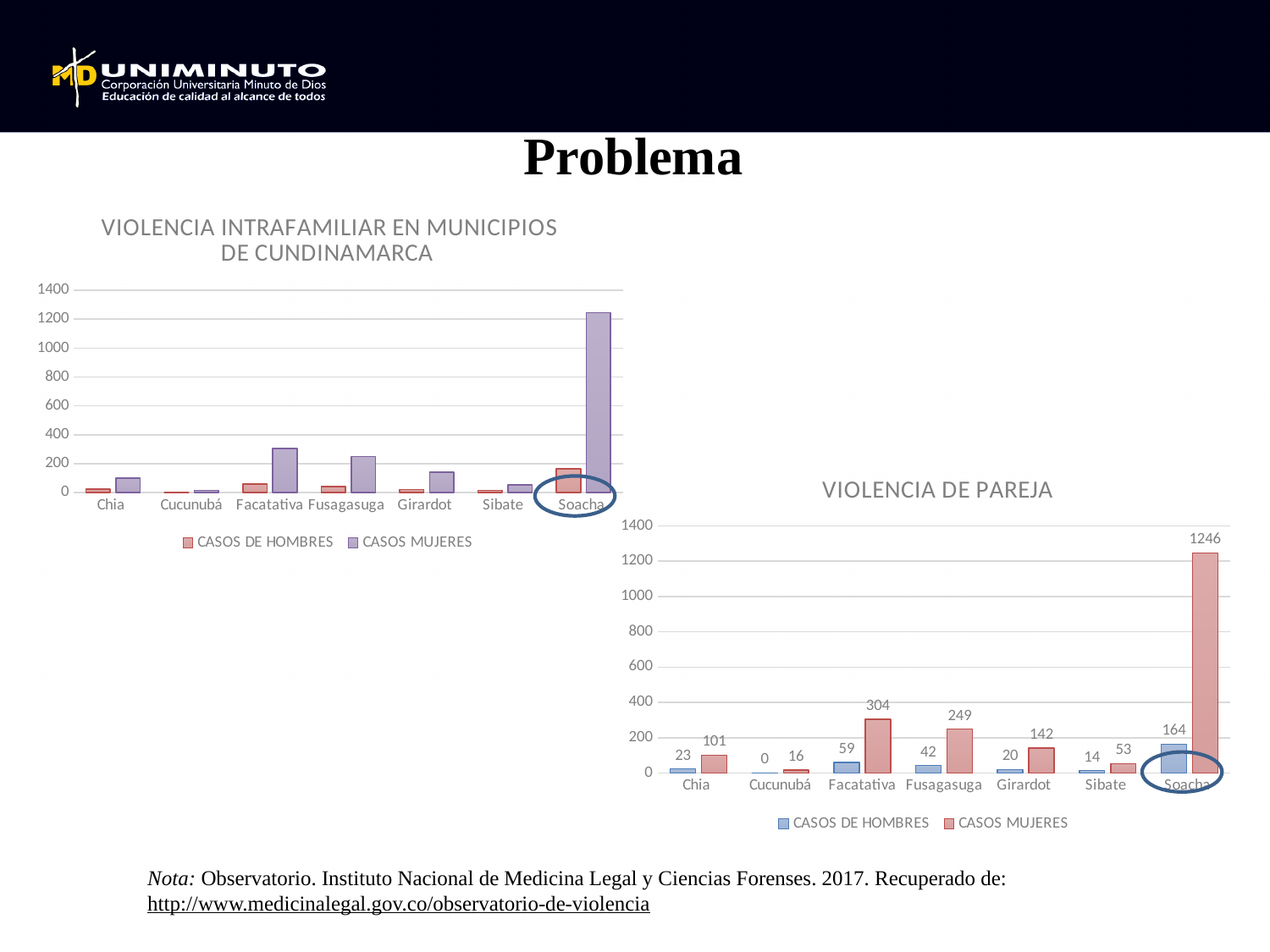
In the VIOLENCIA DE PAREJA chart, what is the value of CASOS DE HOMBRES for Facatativa? 59 In the VIOLENCIA DE PAREJA chart, how many series does the legend list? 2 In the VIOLENCIA DE PAREJA chart, what is the difference between CASOS MUJERES and CASOS DE HOMBRES for Fusagasuga? 207 In the VIOLENCIA DE PAREJA chart, what is the value of CASOS MUJERES for Girardot? 142 In the VIOLENCIA INTRAFAMILIAR EN MUNICIPIOS DE CUNDINAMARCA chart, is the value of CASOS MUJERES for Chia greater or less than 200? less In the VIOLENCIA DE PAREJA chart, which is larger: CASOS MUJERES for Facatativa or CASOS MUJERES for Fusagasuga? Facatativa In the VIOLENCIA INTRAFAMILIAR EN MUNICIPIOS DE CUNDINAMARCA chart, is the value of CASOS MUJERES for Soacha greater or less than 1000? greater In the VIOLENCIA DE PAREJA chart, which municipality has the lowest value for CASOS DE HOMBRES? Cucunubá In the VIOLENCIA DE PAREJA chart, what is the value of CASOS MUJERES for Soacha? 1246 In the VIOLENCIA DE PAREJA chart, how many municipalities are shown on the x axis? 7 In the VIOLENCIA DE PAREJA chart, which municipality has the highest value for CASOS MUJERES? Soacha What type of chart is the VIOLENCIA INTRAFAMILIAR EN MUNICIPIOS DE CUNDINAMARCA chart? Bar chart